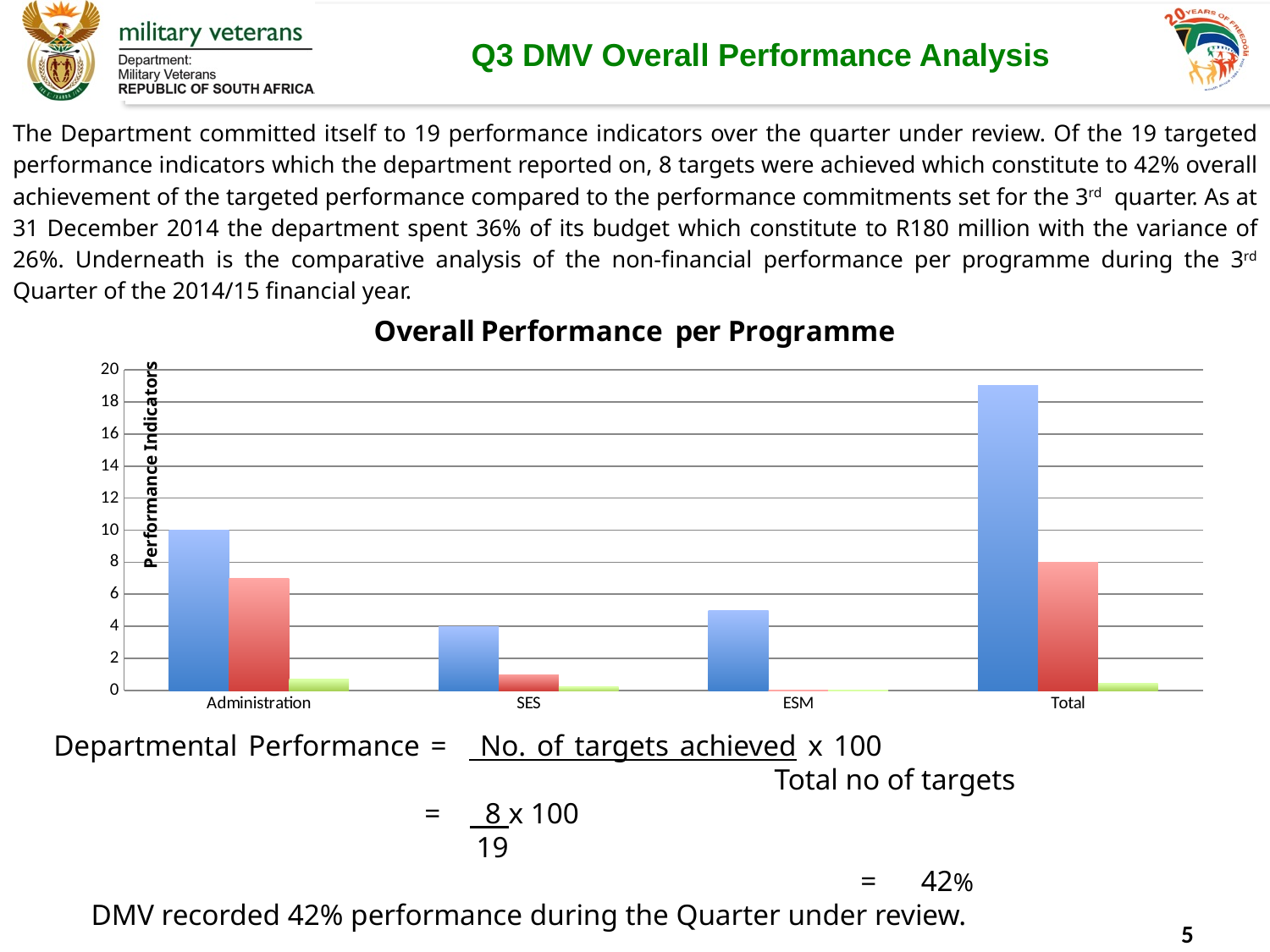
Is the red bar for Administration greater or less than 6? greater What is the value of the blue bar for Administration? 10 What is the value of the red bar for Total? 8 What is the title of the vertical axis of the chart? Performance Indicators Which has the larger blue bar, Administration or SES? Administration What is the value of the blue bar for SES? 4 How many categories are shown on the x axis of the chart? 4 What type of chart is shown under the heading 'Overall Performance per Programme'? bar chart Which category has the tallest blue bar? Total Is the blue bar for Total greater or less than 18? greater What is the difference between the blue bar for Administration and the blue bar for SES? 6 Is the blue bar for ESM greater or less than 4? greater